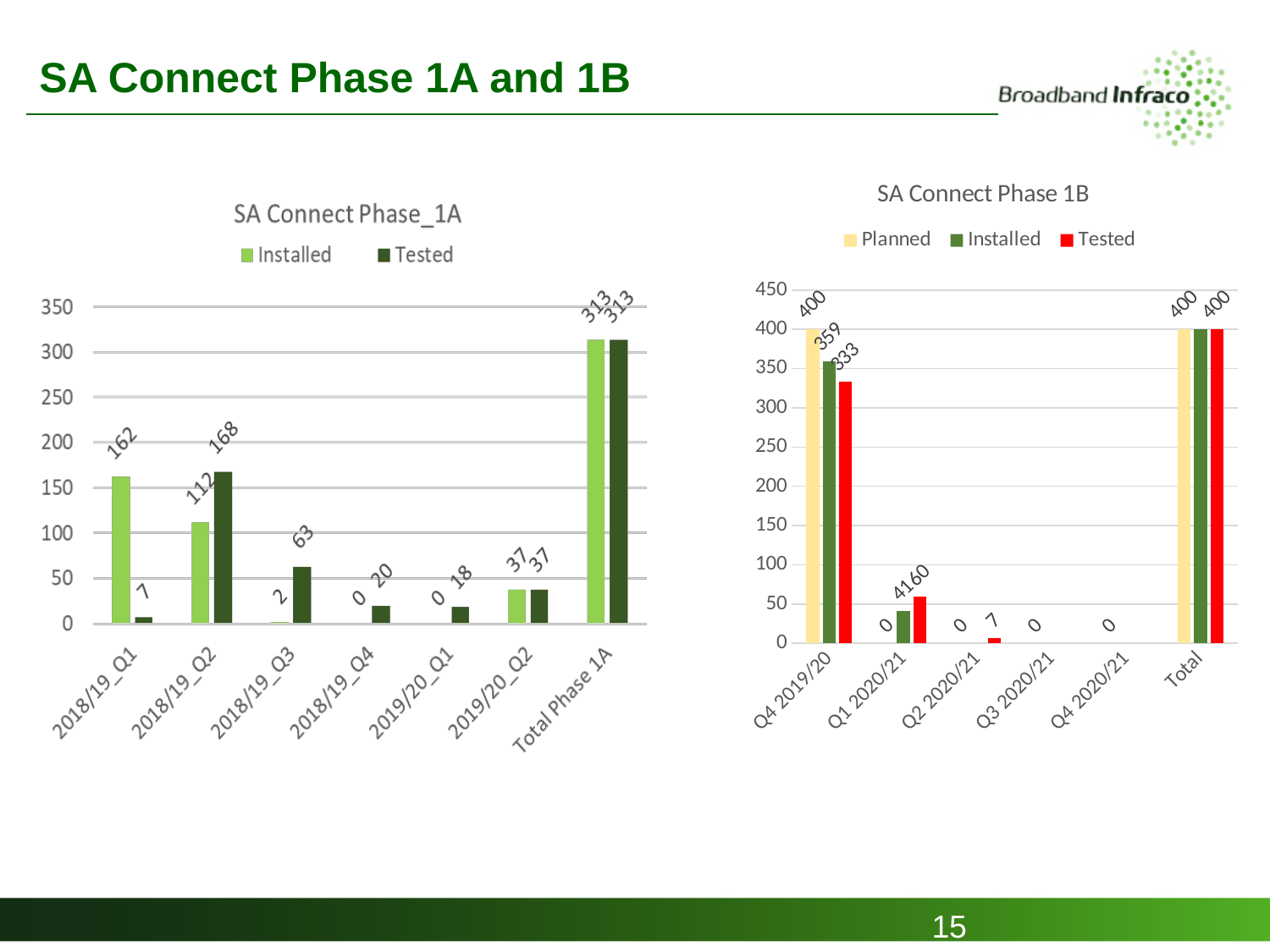
In the SA Connect Phase_1A chart, what is the difference between the Installed and Tested values for 2018/19_Q1? 155 In the SA Connect Phase 1B chart, how many series does the legend list? 3 In the SA Connect Phase_1A chart, which category has the highest Tested value? Total Phase 1A In the SA Connect Phase_1A chart, what is the Installed value for 2018/19_Q1? 162 In the SA Connect Phase_1A chart, is the Installed value for 2018/19_Q2 larger or smaller than the Tested value for the same quarter? smaller In the SA Connect Phase 1B chart, what is the Installed value for Q4 2019/20? 359 In the SA Connect Phase 1B chart, what is the Tested value for Q4 2019/20? 333 In the SA Connect Phase 1B chart, what is the Planned value for Total? 400 What type of chart is the SA Connect Phase 1B chart? bar chart In the SA Connect Phase_1A chart, how many series does the legend list? 2 In the SA Connect Phase_1A chart, what is the Tested value for 2018/19_Q2? 168 In the SA Connect Phase_1A chart, what is the Tested value for 2018/19_Q3? 63